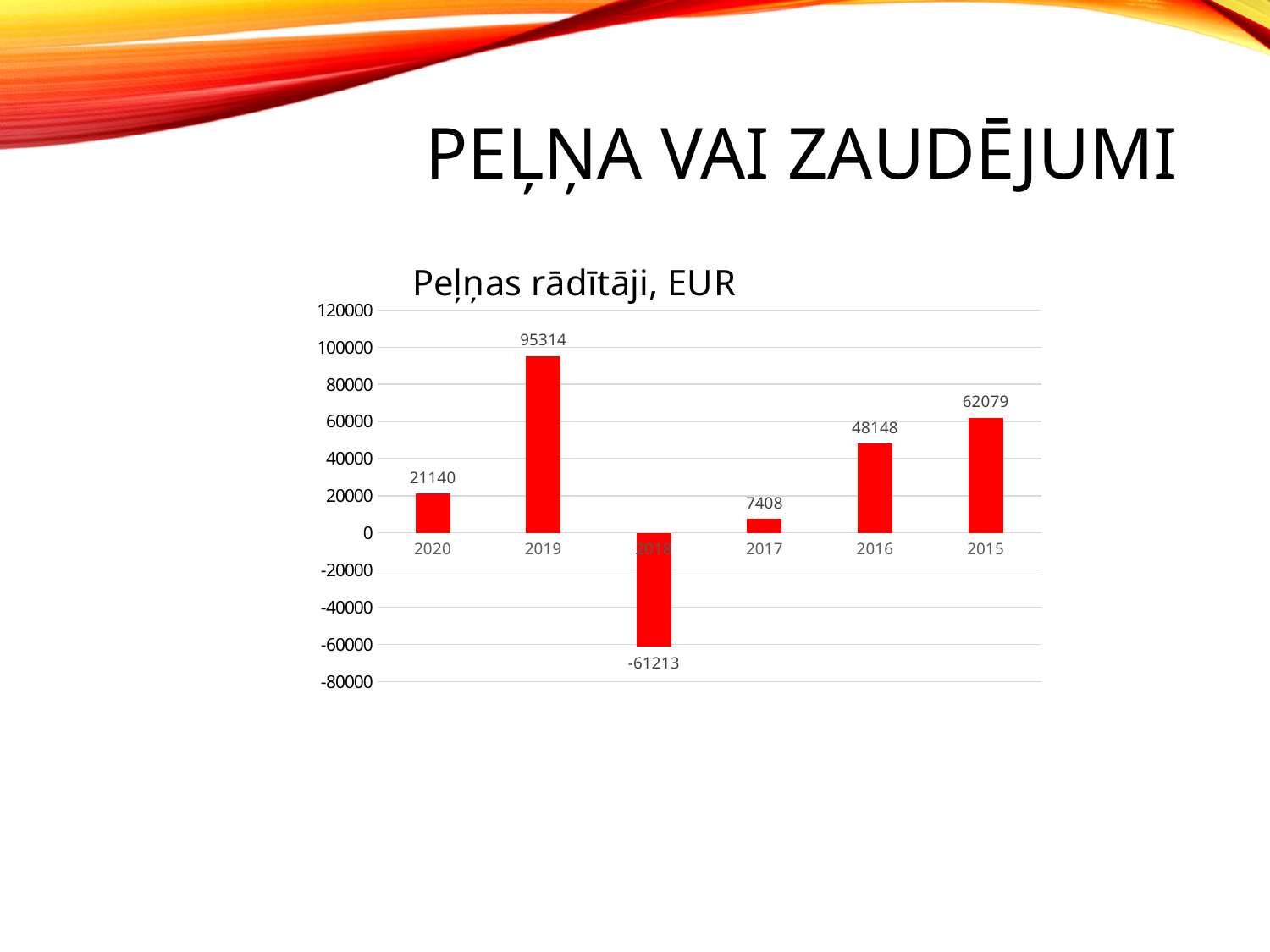
What is the value for 2018 in the chart? -61213 What is the title of the chart? Peļņas rādītāji, EUR Which year has the highest value in the chart? 2019 Is the value for 2015 greater or less than 60000? greater Which year has the lowest value in the chart? 2018 How many years are shown in the chart? 6 What is the value for 2019 in the chart? 95314 Which is larger, the value for 2020 or the value for 2017? 2020 What is the value for 2016 in the chart? 48148 What is the value for 2020 in the chart? 21140 What is the difference between the values for 2015 and 2016? 13931 What kind of chart is shown on the slide? bar chart